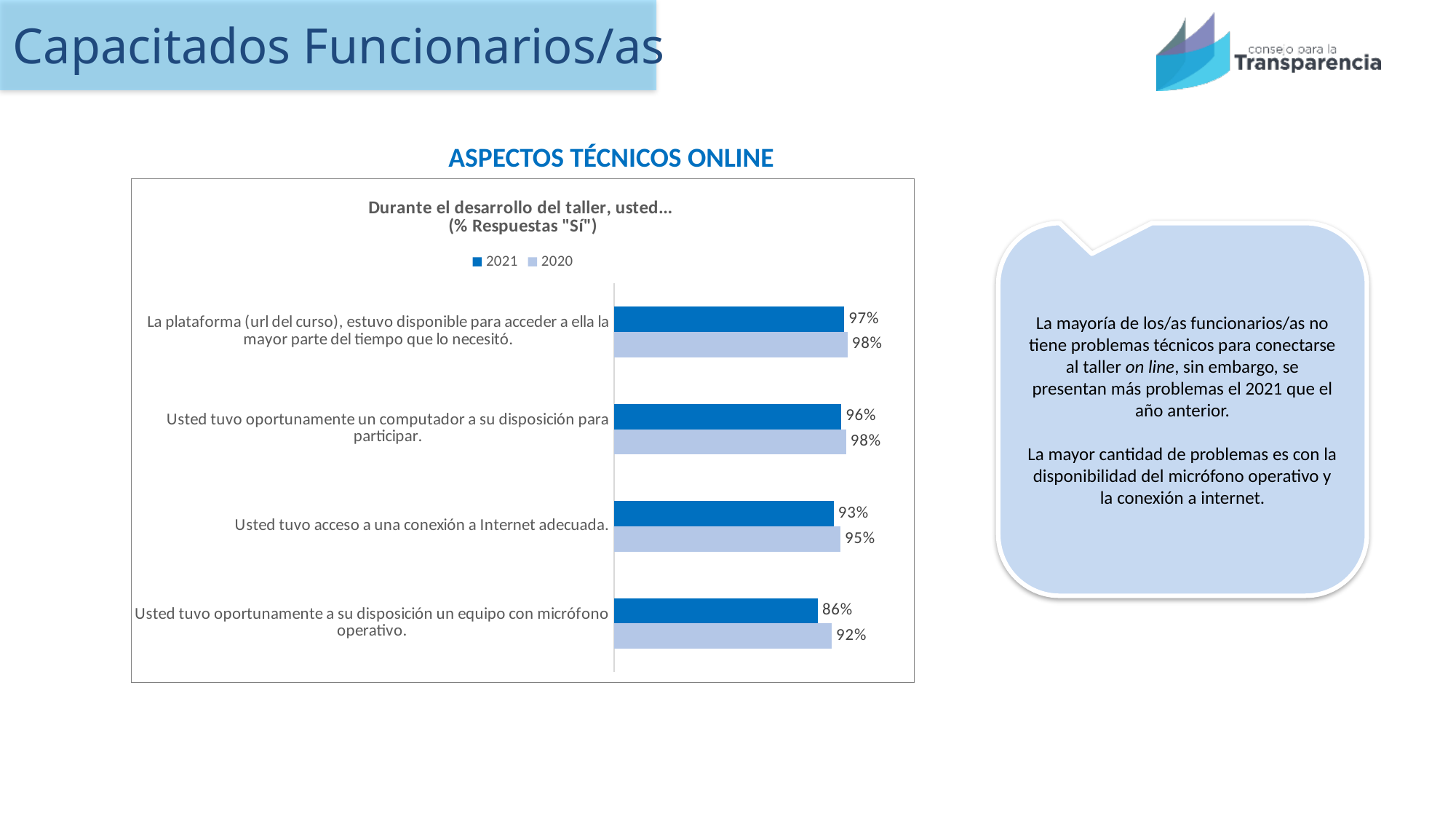
What kind of chart is shown on the slide? Bar chart Which category has the highest 2021 value? La plataforma (url del curso), estuvo disponible para acceder a ella la mayor parte del tiempo que lo necesitó. What is the title of the chart? Durante el desarrollo del taller, usted... (% Respuestas "Sí") What is the difference between the 2020 and 2021 values for "Usted tuvo oportunamente a su disposición un equipo con micrófono operativo."? 6% What is the 2021 value for "Usted tuvo acceso a una conexión a Internet adecuada."? 93% What is the 2021 value for "La plataforma (url del curso), estuvo disponible para acceder a ella la mayor parte del tiempo que lo necesitó."? 97% What is the 2020 value for "Usted tuvo oportunamente a su disposición un equipo con micrófono operativo."? 92% Which category has the lowest 2021 value? Usted tuvo oportunamente a su disposición un equipo con micrófono operativo. How many categories are shown in the chart? 4 For "Usted tuvo acceso a una conexión a Internet adecuada.", which year has the larger value, 2021 or 2020? 2020 What is the 2020 value for "Usted tuvo oportunamente un computador a su disposición para participar."? 98% How many series does the legend list? 2